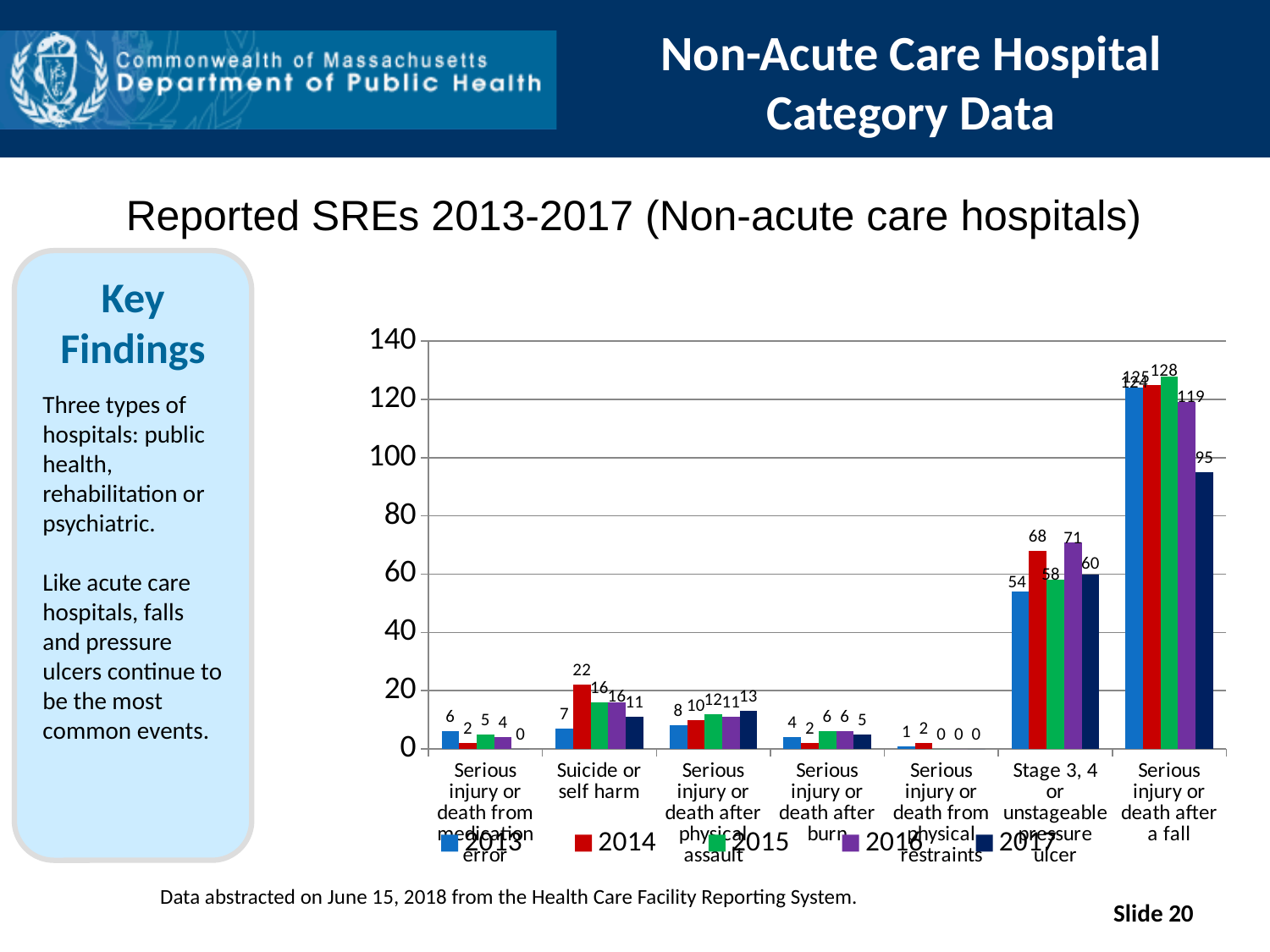
Which is larger for Serious injury or death after physical assault: the 2017 value or the 2013 value? 2017 What is the difference between the 2014 and 2013 values for Stage 3, 4 or unstageable pressure ulcer? 14 Is the 2016 value for Serious injury or death after a fall greater or less than 100? greater What is the 2015 value for Serious injury or death after a fall? 128 What is the 2014 value for Suicide or self harm? 22 What is the 2016 value for Stage 3, 4 or unstageable pressure ulcer? 71 How many event categories are shown on the x axis? 7 Which year has the highest value for Stage 3, 4 or unstageable pressure ulcer? 2016 Which year has the lowest value for Serious injury or death after a fall? 2017 What is the 2017 value for Serious injury or death after a fall? 95 What type of chart is shown on the slide? bar chart How many series does the legend list? 5